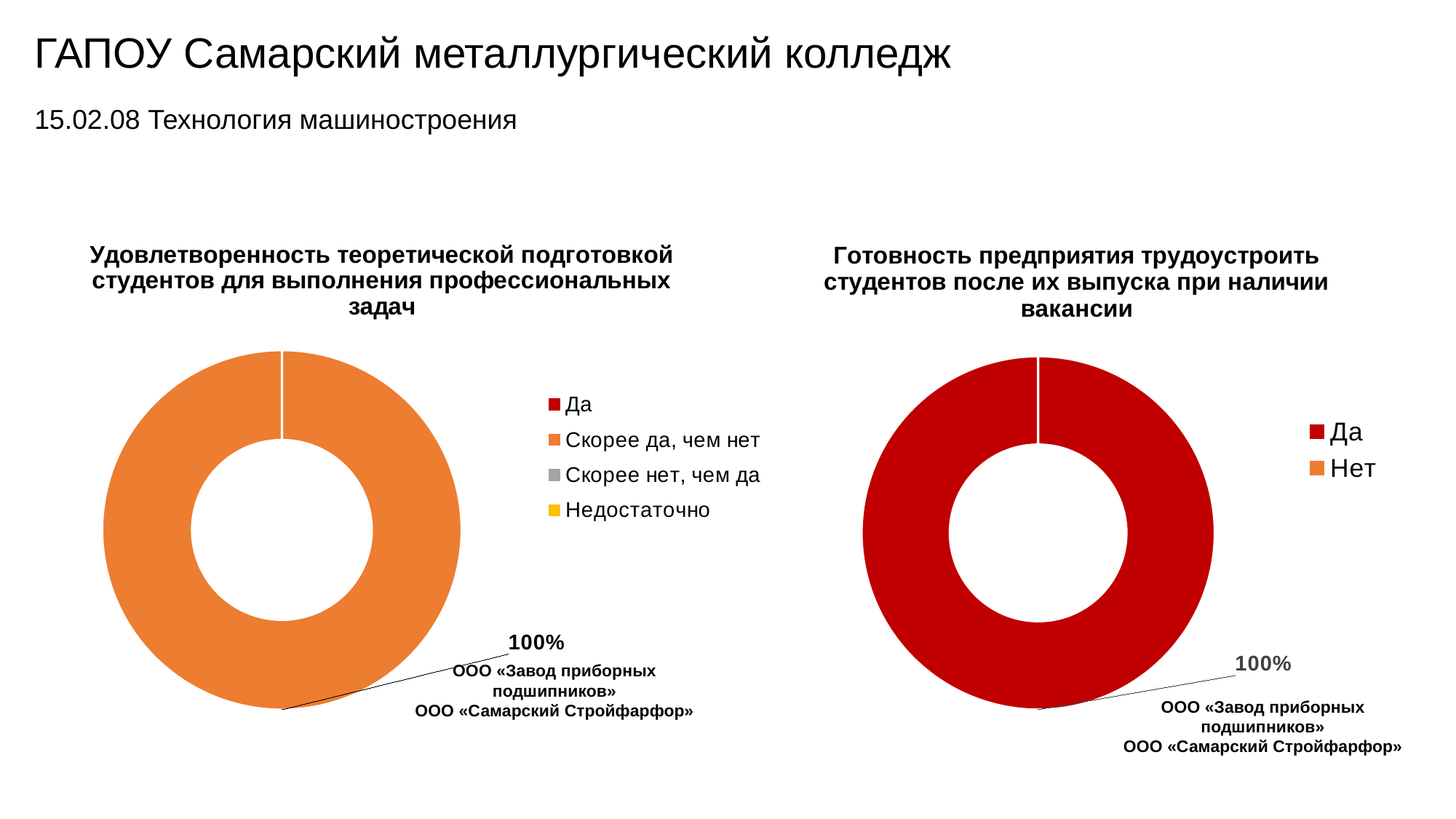
In the right chart (Готовность предприятия трудоустроить студентов), which legend category accounts for the entire ring? Да In the left chart (Удовлетворенность теоретической подготовкой), what share of the ring does "Скорее да, чем нет" take? 100% In the left chart (Удовлетворенность теоретической подготовкой), which is larger: the share for "Скорее да, чем нет" or the share for "Недостаточно"? Скорее да, чем нет Which two companies are named in the data label of the left chart (Удовлетворенность теоретической подготовкой)? ООО «Завод приборных подшипников» and ООО «Самарский Стройфарфор» In the right chart (Готовность предприятия трудоустроить студентов), what share of the ring does "Да" take? 100% How many entries does the legend of the left chart (Удовлетворенность теоретической подготовкой) list? 4 What kind of chart is the left chart titled "Удовлетворенность теоретической подготовкой студентов для выполнения профессиональных задач"? Doughnut (pie) chart In the left chart (Удовлетворенность теоретической подготовкой), which legend category accounts for the entire ring? Скорее да, чем нет How many entries does the legend of the right chart (Готовность предприятия трудоустроить студентов) list? 2 What colour is the ring of the right chart (Готовность предприятия трудоустроить студентов)? Red What kind of chart is the right chart titled "Готовность предприятия трудоустроить студентов после их выпуска при наличии вакансии"? Doughnut (pie) chart In the right chart (Готовность предприятия трудоустроить студентов), which is larger: the share for "Да" or the share for "Нет"? Да